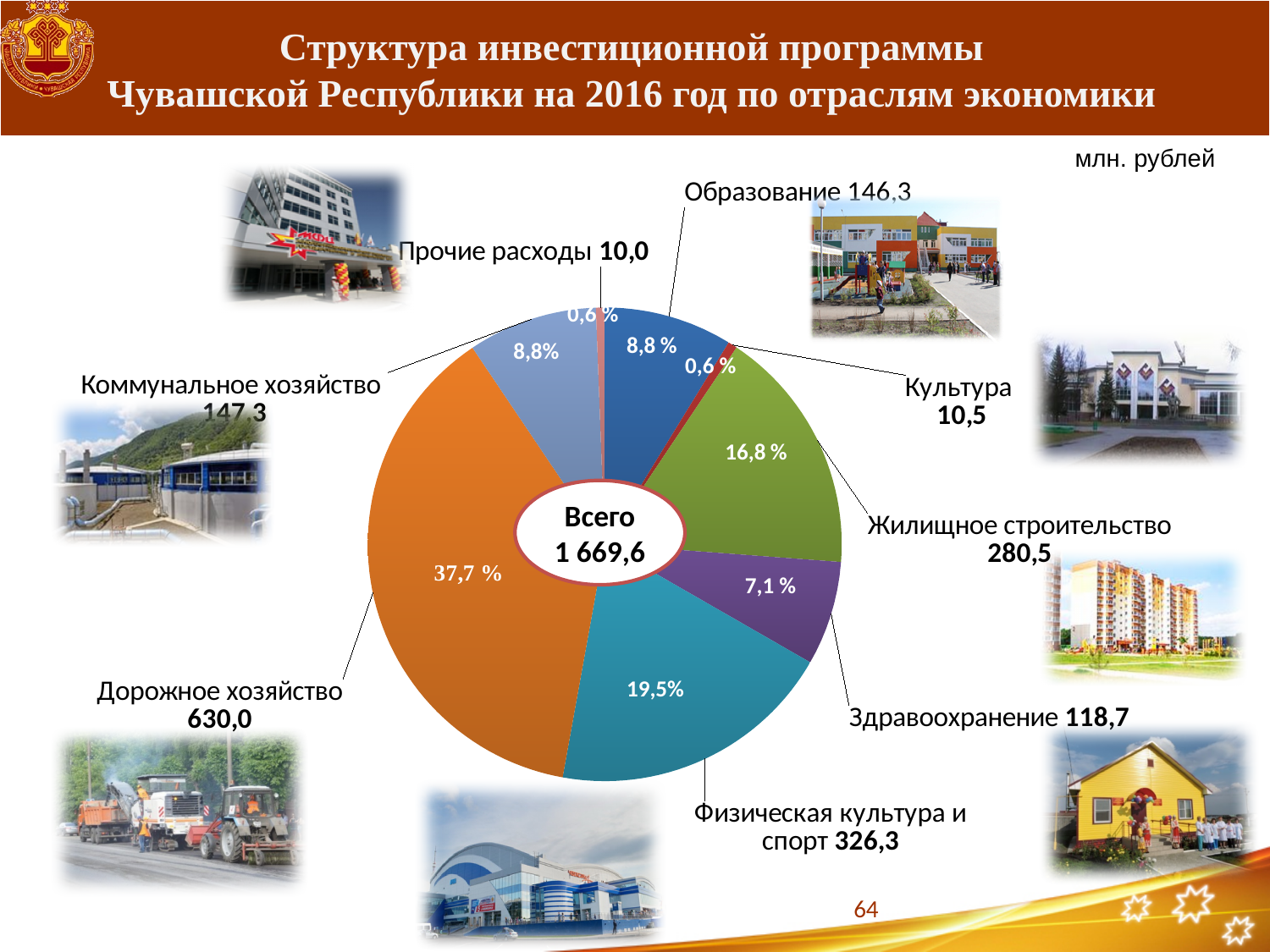
What is the value for Здравоохранение? 118,7 How many categories are shown in the pie chart? 8 What share of the pie does Жилищное строительство take? 16,8 % What is the value for Дорожное хозяйство? 630,0 What total value is shown in the centre of the pie chart? 1 669,6 Which category has the largest value? Дорожное хозяйство Which category has the smallest value? Прочие расходы What kind of chart is shown on the slide? pie chart What is the value for Жилищное строительство? 280,5 Which is larger, the value for Образование or the value for Коммунальное хозяйство? Коммунальное хозяйство What is the value for Физическая культура и спорт? 326,3 What is the difference between the values for Дорожное хозяйство and Физическая культура и спорт? 303,7